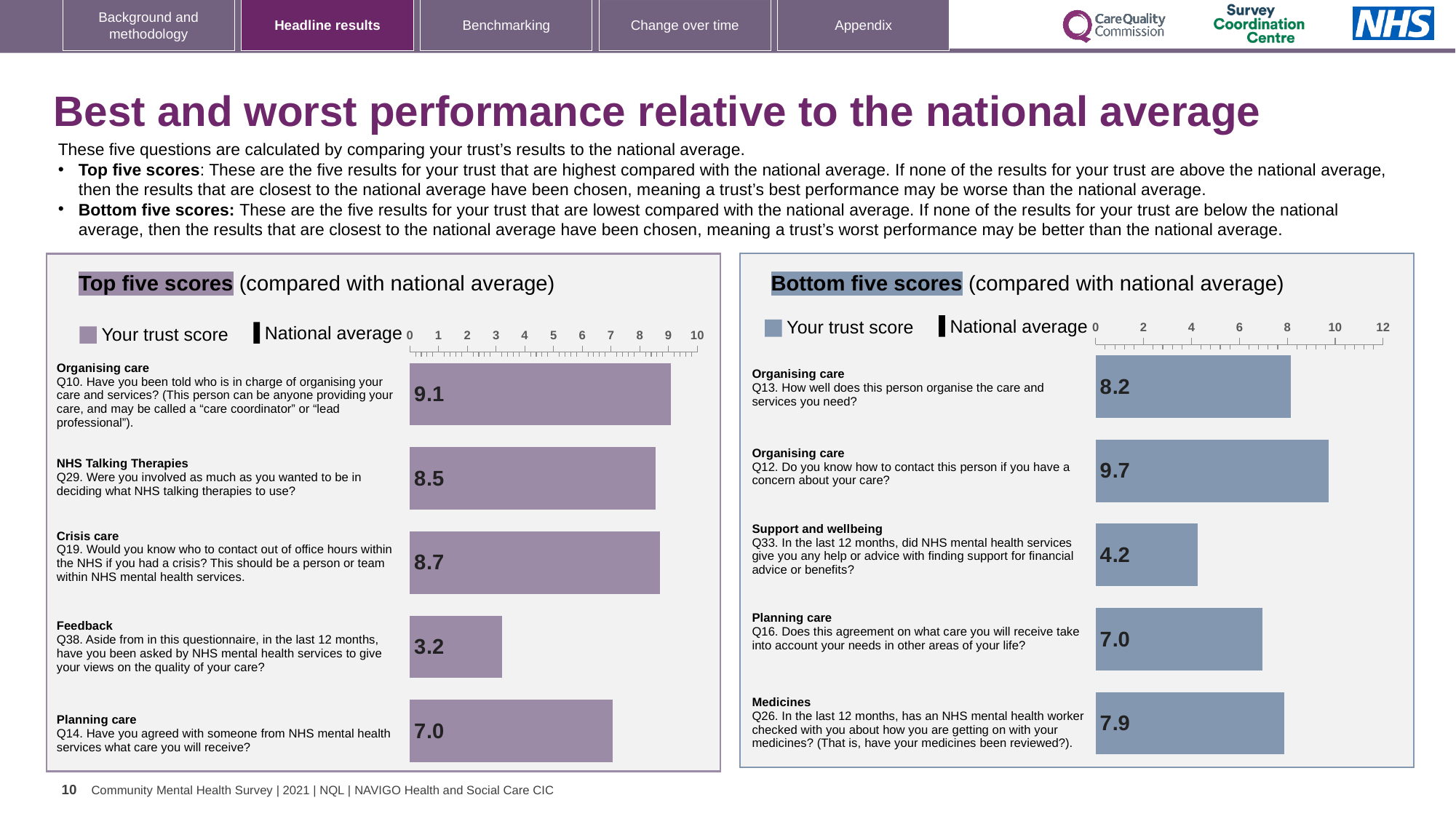
In the Bottom five scores chart, which question has the lowest trust score? Q33 (Support and wellbeing) In the Top five scores chart, what is the trust score for Q38 (Feedback)? 3.2 In the Bottom five scores chart, what is the trust score for Q12 (Organising care)? 9.7 In the Top five scores chart, which question has the highest trust score? Q10 (Organising care) How many questions are shown in the Top five scores chart? 5 In the Bottom five scores chart, what is the difference between the trust scores for Q12 and Q16? 2.7 In the Bottom five scores chart, which is larger: the trust score for Q13 or for Q26? Q13 In the Top five scores chart, which question has the lowest trust score? Q38 (Feedback) In the Top five scores chart, what is the difference between the trust scores for Q19 (Crisis care) and Q29 (NHS Talking Therapies)? 0.2 In the Bottom five scores chart, what is the trust score for Q33 (Support and wellbeing)? 4.2 In the Top five scores chart, what is the trust score for Q10 (Organising care)? 9.1 What type of chart is the Bottom five scores chart? Bar chart